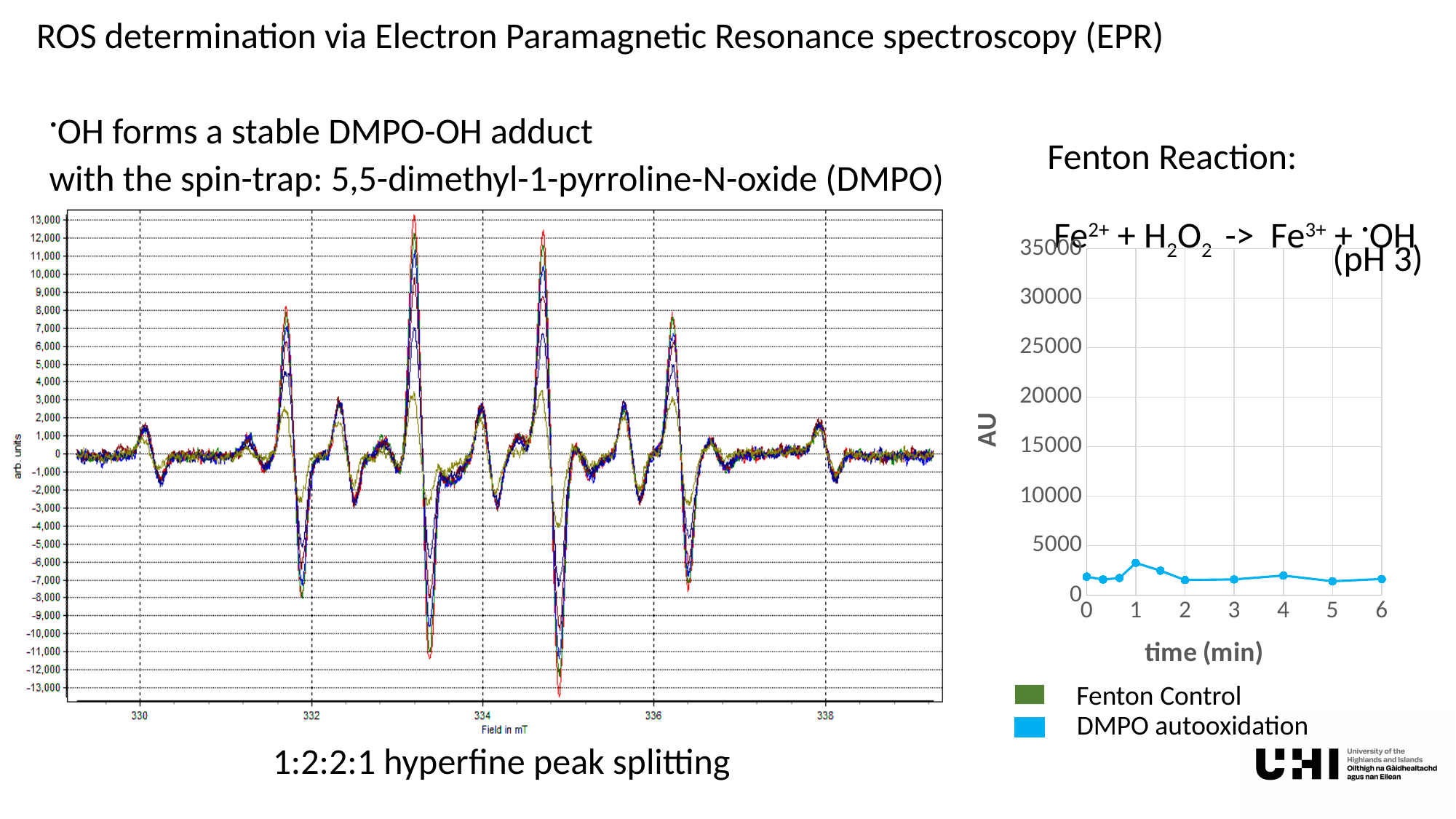
In the EPR spectrum chart on the left, is the peak near 331.8 mT larger or smaller than the peak near 333.3 mT? smaller In the Fenton Reaction chart, is the DMPO autooxidation value at 6 min greater or less than 5000? less What kind of chart is the Fenton Reaction chart on the right of the slide? line chart In the Fenton Reaction chart, at which time (min) does the DMPO autooxidation series reach its highest value? 1 How many data points are plotted for the DMPO autooxidation series in the Fenton Reaction chart? 10 In the EPR spectrum chart on the left, is the tallest peak near 333.3 mT greater or less than 10,000 arb. units? greater In the Fenton Reaction chart, which series is shown in blue? DMPO autooxidation What is the x-axis label of the Fenton Reaction chart? time (min) How many series does the legend of the Fenton Reaction chart list? 2 In the EPR spectrum chart on the left, is the peak near 330.1 mT greater or less than 5,000 arb. units? less In the Fenton Reaction chart, does the DMPO autooxidation value rise or fall between 1 min and 2 min? fall